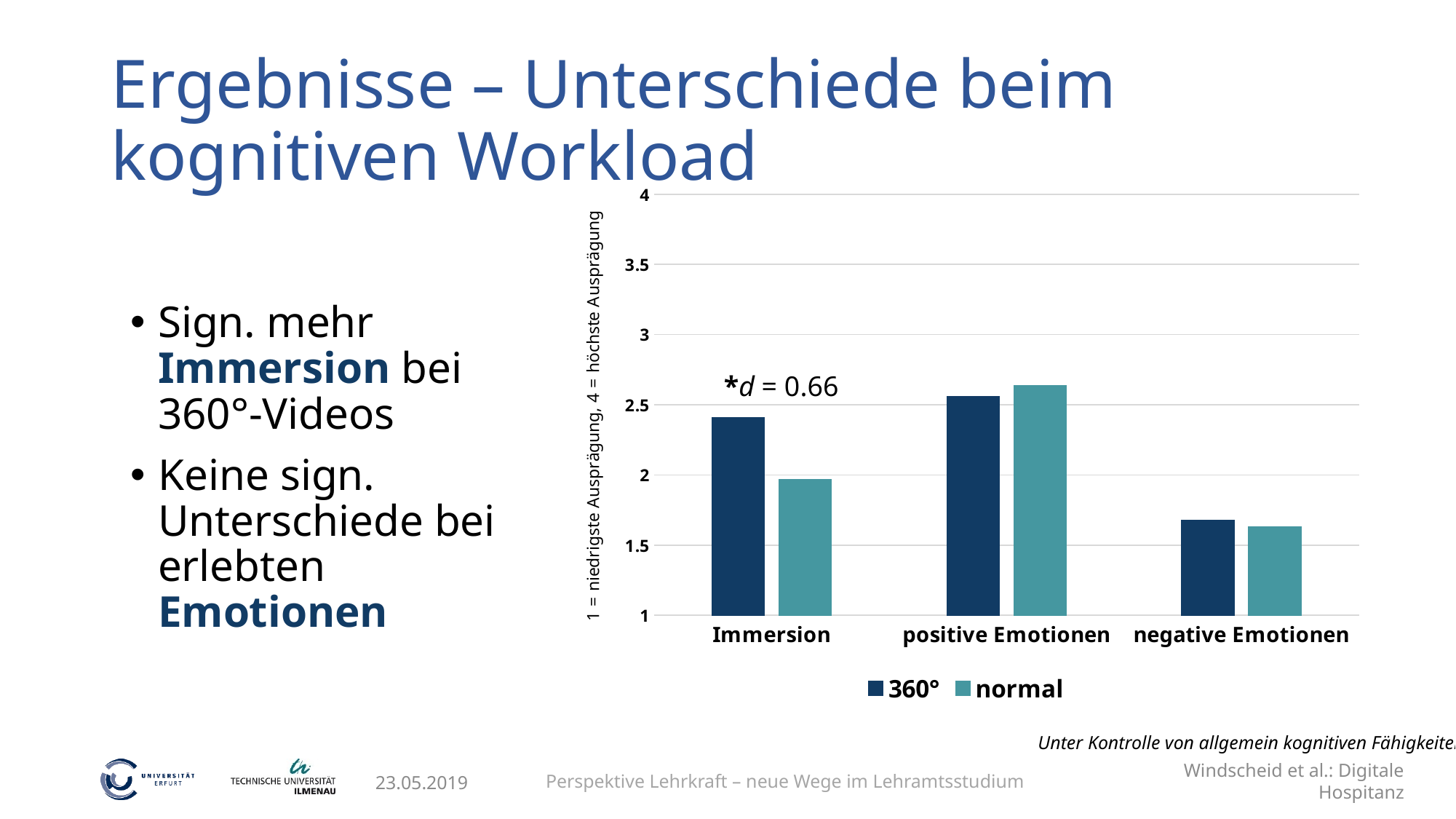
Within the normal series, which category has the lowest value? negative Emotionen Which category has the annotation "*d = 0.66" above its bars? Immersion Is the normal value for positive Emotionen greater or less than 2.5? greater What kind of chart is shown on the slide? bar chart Is the 360° value for Immersion greater or less than 2? greater Within the 360° series, which category has the highest value? positive Emotionen What are the two series named in the chart legend? 360° and normal How many categories are shown on the x axis of the chart? 3 Is the 360° value for Immersion greater or less than 2.5? less How many series does the chart legend list? 2 For Immersion, which series has the larger value, 360° or normal? 360°